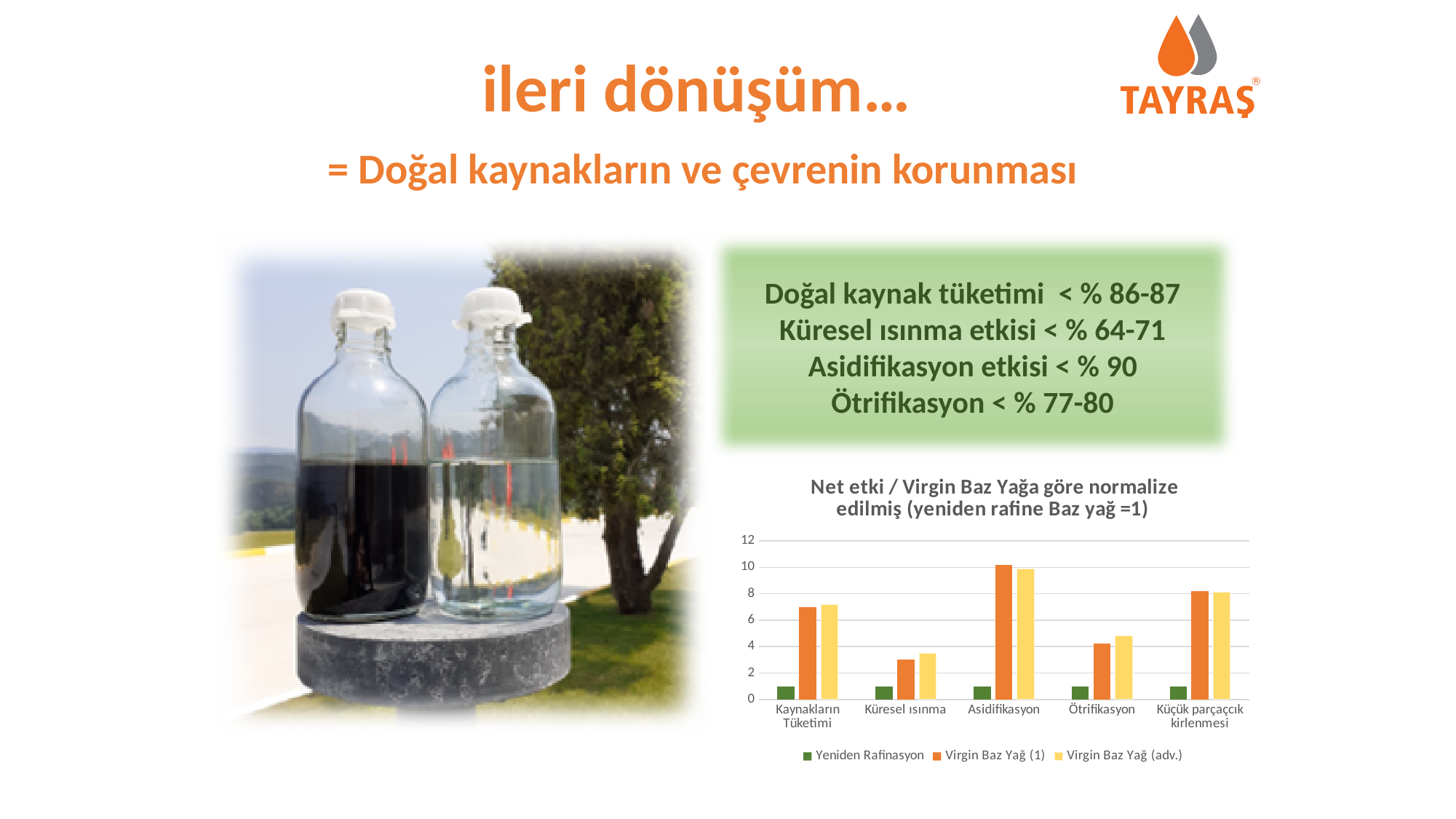
How many series does the chart's legend list? 3 For Ötrifikasyon, which is larger: the Virgin Baz Yağ (1) value or the Virgin Baz Yağ (adv.) value? Virgin Baz Yağ (adv.) What is the title of the chart? Net etki / Virgin Baz Yağa göre normalize edilmiş (yeniden rafine Baz yağ =1) Is the Virgin Baz Yağ (1) value for Asidifikasyon greater or less than 8? greater Which category has the highest value for the Virgin Baz Yağ (1) series? Asidifikasyon Which category has the lowest value for the Virgin Baz Yağ (1) series? Küresel ısınma What colour represents the Yeniden Rafinasyon series in the chart? green What kind of chart is shown on the slide? bar chart Which category has the highest value for the Virgin Baz Yağ (adv.) series? Asidifikasyon Is the Virgin Baz Yağ (1) value for Kaynakların Tüketimi greater or less than 6? greater How many categories are shown on the x axis of the chart? 5 Is the Virgin Baz Yağ (adv.) value for Küresel ısınma greater or less than 4? less